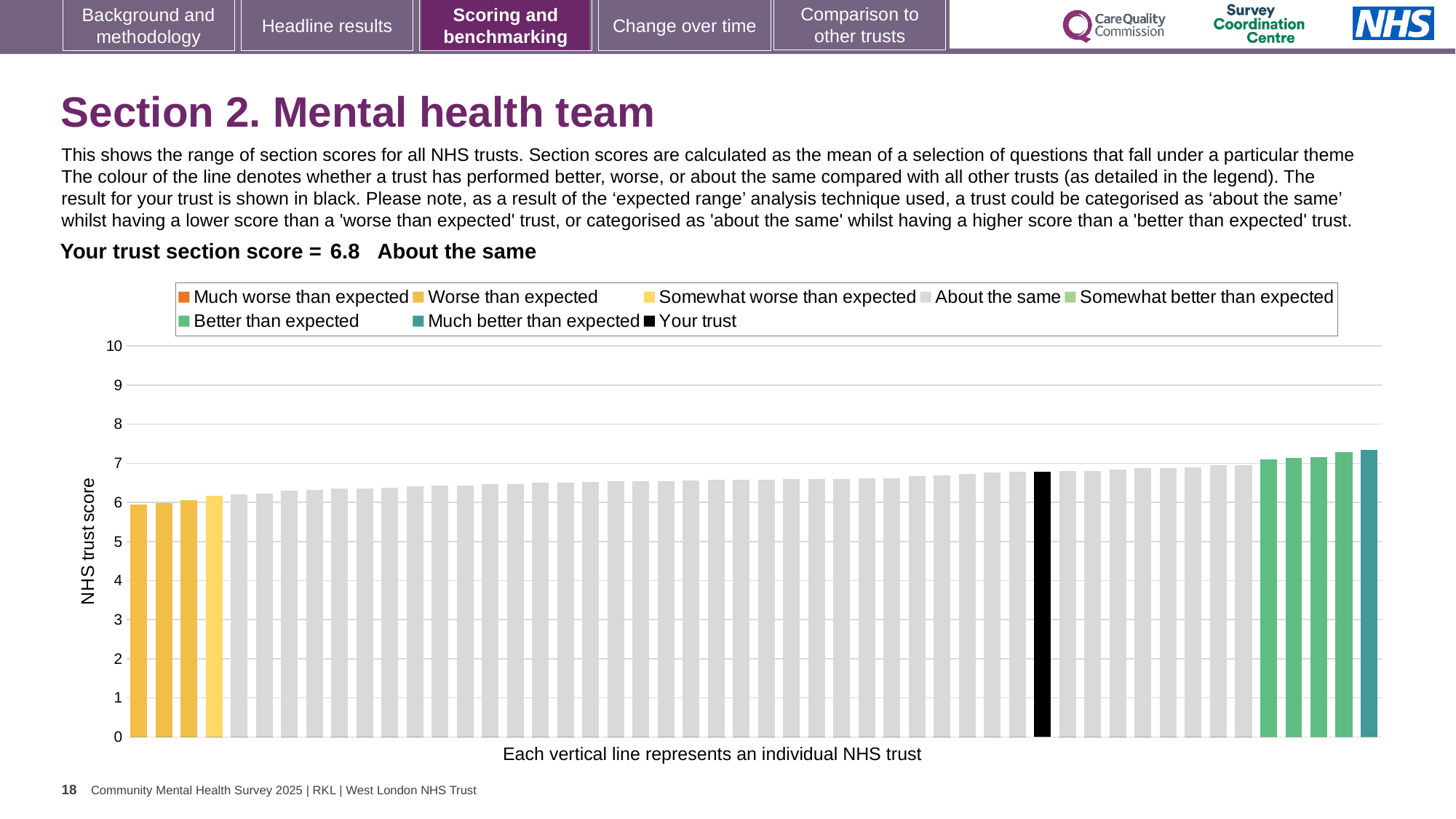
What kind of chart is shown on the slide? Bar chart What is the label on the vertical axis of the chart? NHS trust score How many entries does the chart legend list? 8 Do the bar values rise or fall moving from left to right along the x axis? Rise How many bars are coloured as 'Better than expected' (green)? 4 Is the tallest bar in the chart greater or less than 8? less Which performance category is your trust placed in for this section? About the same Is the black 'Your trust' bar higher or lower than the teal 'Much better than expected' bar? lower Is the value for your trust (the black bar) greater or less than 6? greater Is the shortest bar in the chart greater or less than 5? greater What is the section score for your trust shown on the slide? 6.8 How many bars are coloured as 'Much better than expected' (teal)? 1